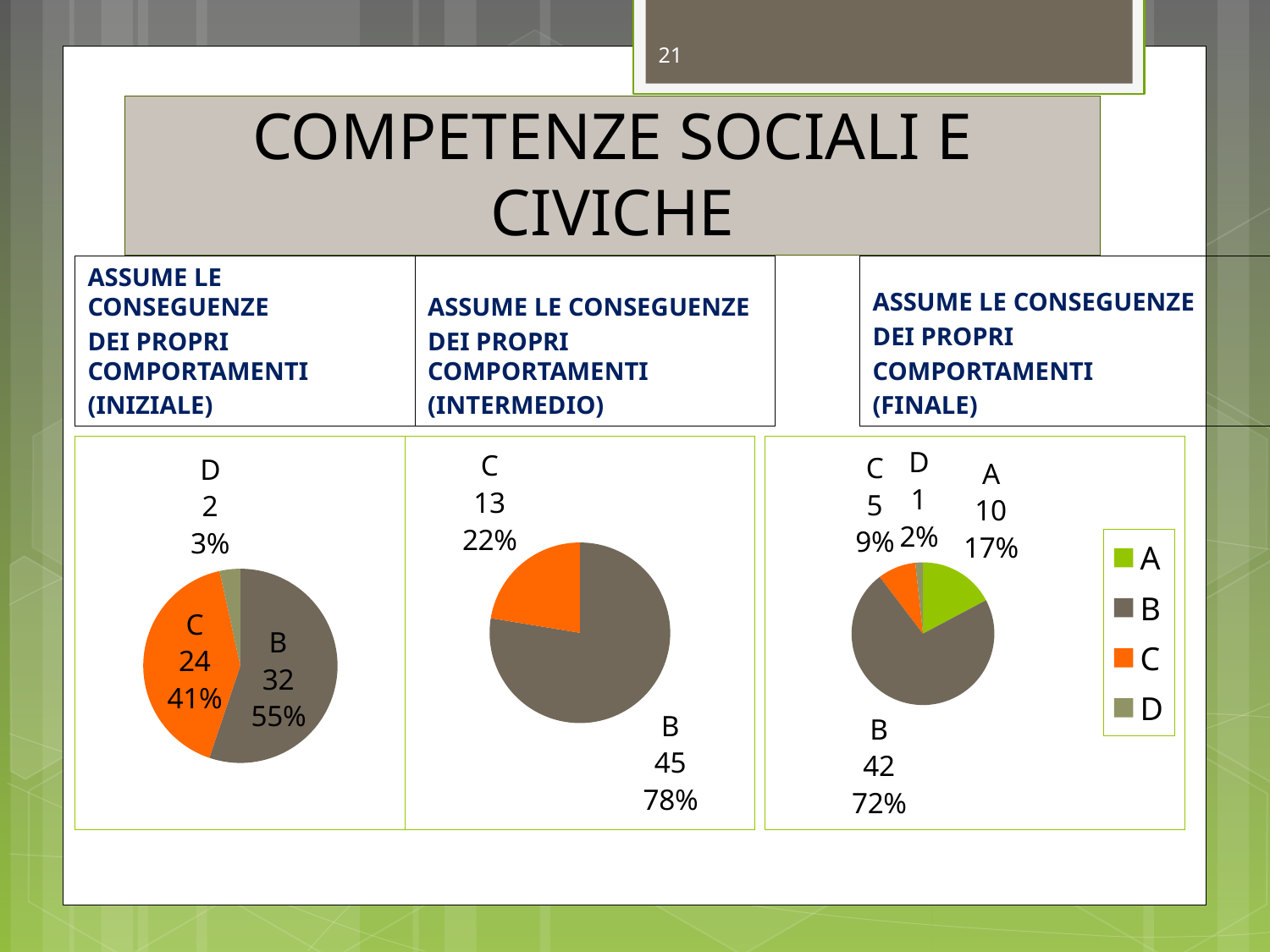
In the INIZIALE pie chart (left), which category has the smallest slice? D How many slices does the INTERMEDIO pie chart (middle) have? 2 How many entries does the legend next to the FINALE pie chart (right) list? 4 What type of chart is used in the INIZIALE chart (left)? Pie chart In the INIZIALE pie chart (left), what is the difference between the values for B and C? 8 In the INTERMEDIO pie chart (middle), what is the value for category C? 13 In the INTERMEDIO pie chart (middle), what share of the pie does category B represent? 78% In the INIZIALE pie chart (left), what is the value for category B? 32 In the INIZIALE pie chart (left), what share of the pie does category C represent? 41% In the FINALE pie chart (right), what is the value for category A? 10 In the FINALE pie chart (right), which category has the largest slice? B In the FINALE pie chart (right), which is larger, the value for A or the value for C? A